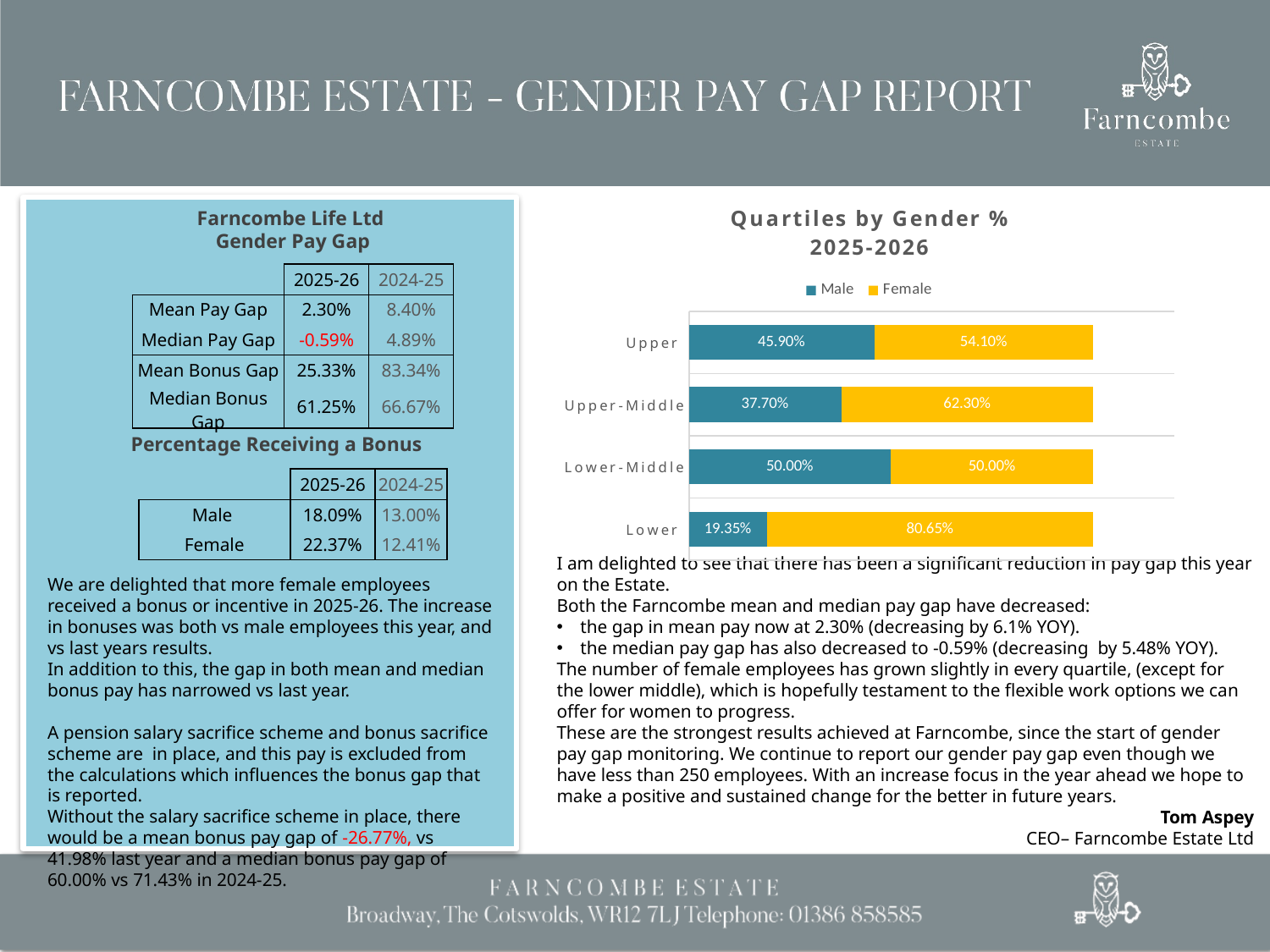
How many series does the legend of the Quartiles by Gender % chart list? 2 What type of chart is the Quartiles by Gender % chart? Stacked bar chart How many quartile categories are shown in the Quartiles by Gender % chart? 4 What is the total of the Male and Female percentages for the Lower quartile bar? 100.00% What is the Female value for the Lower quartile in the Quartiles by Gender % chart? 80.65% Which quartile has the lowest Male percentage in the Quartiles by Gender % chart? Lower What is the Male value for the Upper quartile in the Quartiles by Gender % chart? 45.90% What is the Female value for the Upper-Middle quartile in the Quartiles by Gender % chart? 62.30% What is the Male value for the Lower-Middle quartile in the Quartiles by Gender % chart? 50.00% What is the difference between the Female and Male percentages in the Upper quartile? 8.20% In the Upper-Middle quartile, which is larger, the Male or the Female percentage? Female Which quartile has the highest Female percentage in the Quartiles by Gender % chart? Lower